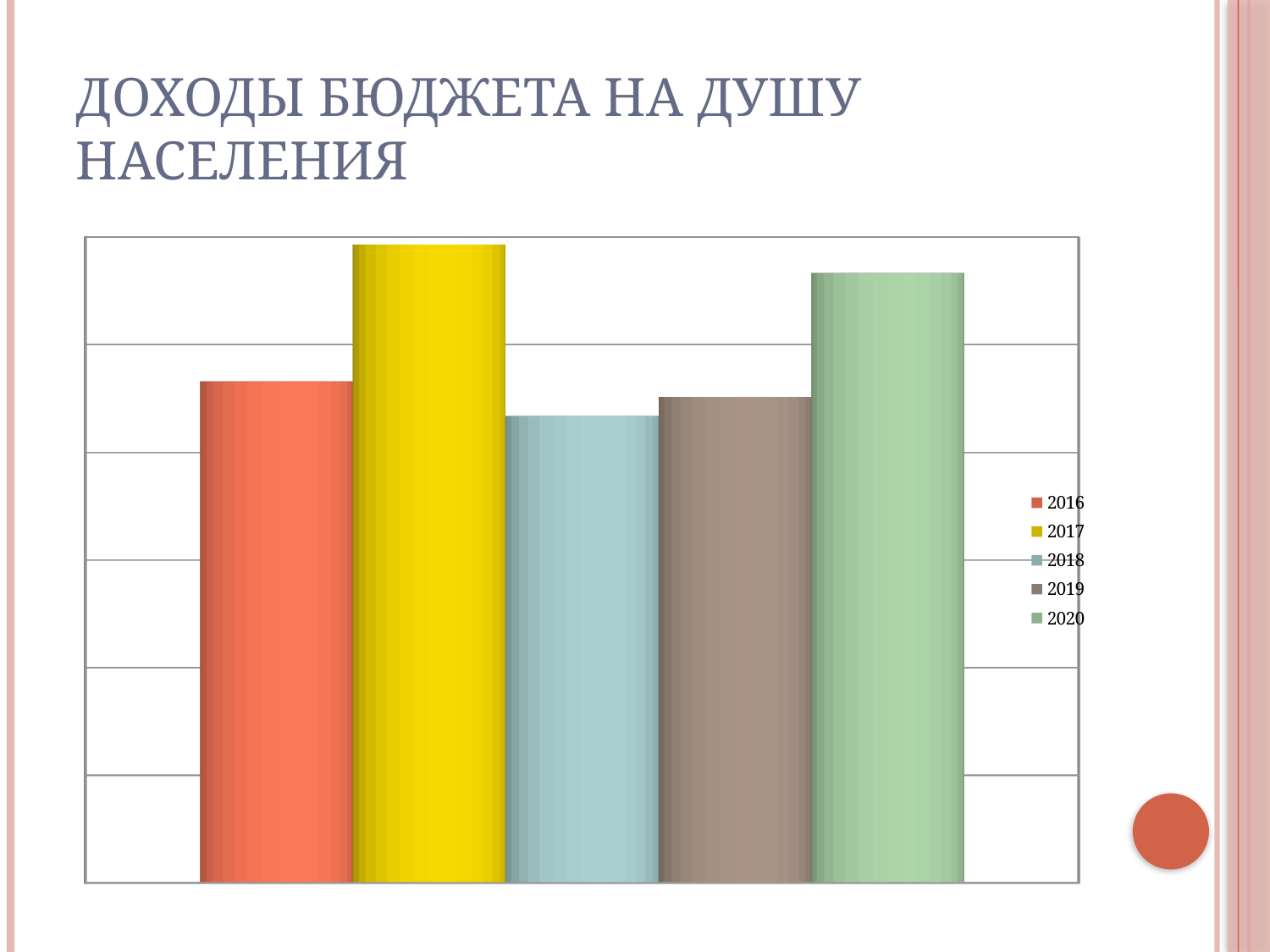
Which is larger, the value for 2019 or the value for 2020? 2020 Which is larger, the value for 2017 or the value for 2018? 2017 What is the title of the slide containing the chart? ДОХОДЫ БЮДЖЕТА НА ДУШУ НАСЕЛЕНИЯ Which year has the lowest bar? 2018 How many bars are plotted in the chart? 5 Which is larger, the value for 2020 or the value for 2016? 2020 What kind of chart is shown on the slide? bar chart Which year is shown in yellow in the legend? 2017 Which year has the highest bar? 2017 How many series does the legend list? 5